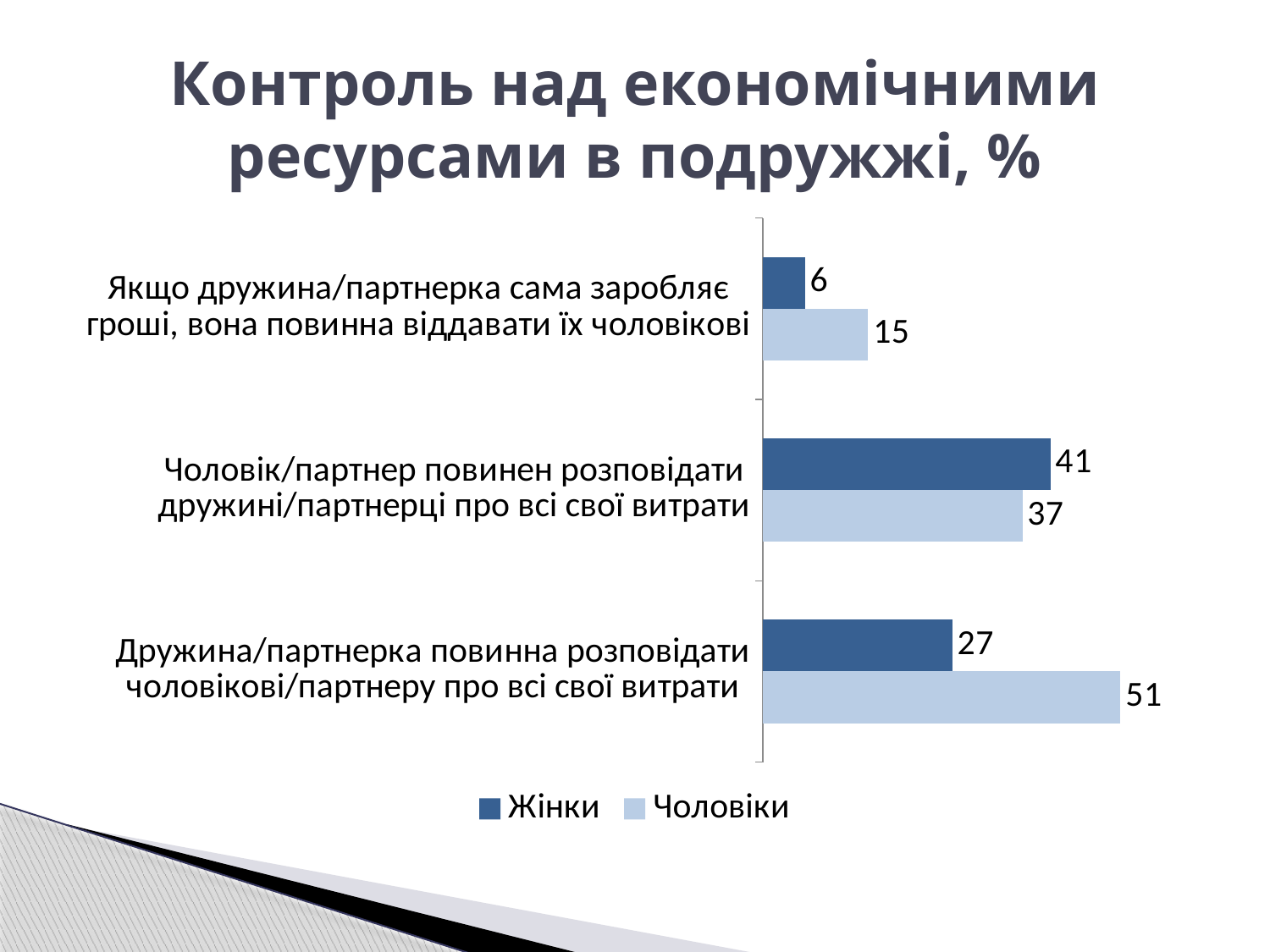
What is the title of the chart? Контроль над економічними ресурсами в подружжі, % Which category has the lowest value for Жінки? Якщо дружина/партнерка сама заробляє гроші, вона повинна віддавати їх чоловікові For the category "Якщо дружина/партнерка сама заробляє гроші, вона повинна віддавати їх чоловікові", which series has the larger value, Жінки or Чоловіки? Чоловіки What is the difference between the Чоловіки and Жінки values for "Дружина/партнерка повинна розповідати чоловікові/партнеру про всі свої витрати"? 24 What kind of chart is shown on the slide? Bar chart What is the value for Чоловіки for the category "Дружина/партнерка повинна розповідати чоловікові/партнеру про всі свої витрати"? 51 How many categories are shown in the chart? 3 How many series does the legend list? 2 What is the value for Чоловіки for the category "Якщо дружина/партнерка сама заробляє гроші, вона повинна віддавати їх чоловікові"? 15 Which category has the highest value for Чоловіки? Дружина/партнерка повинна розповідати чоловікові/партнеру про всі свої витрати What is the difference between the Жінки and Чоловіки values for "Чоловік/партнер повинен розповідати дружині/партнерці про всі свої витрати"? 4 What is the value for Жінки for the category "Чоловік/партнер повинен розповідати дружині/партнерці про всі свої витрати"? 41